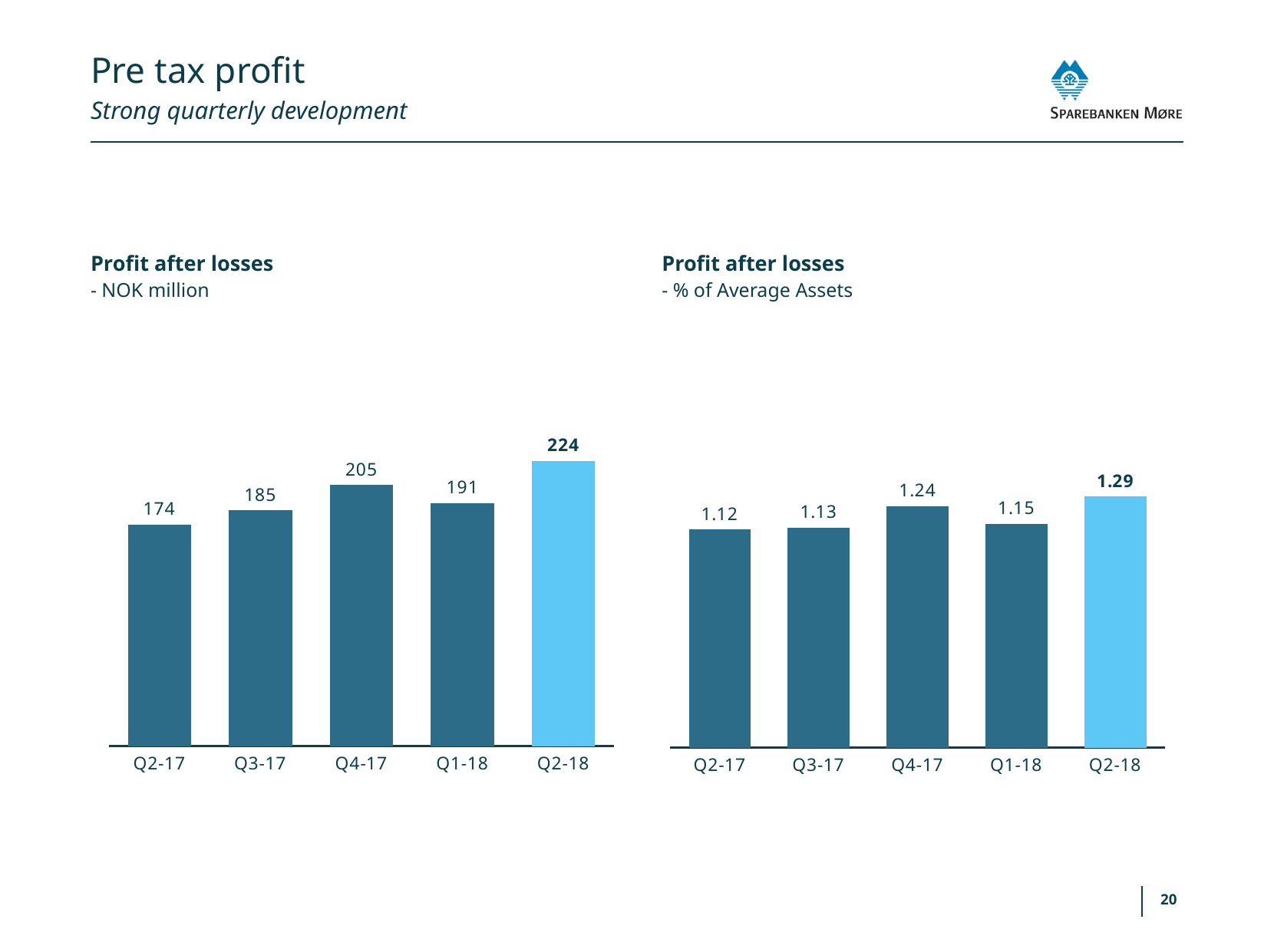
In the left chart (Profit after losses - NOK million), which is larger, Q3-17 or Q1-18? Q1-18 In the right chart (Profit after losses - % of Average Assets), what is the value for Q1-18? 1.15 How many quarters are shown in the right chart (Profit after losses - % of Average Assets)? 5 In the right chart (Profit after losses - % of Average Assets), which quarter has the highest value? Q2-18 In the left chart (Profit after losses - NOK million), which quarter has the lowest value? Q2-17 In the left chart (Profit after losses - NOK million), what is the difference between Q2-18 and Q1-18? 33 In the left chart (Profit after losses - NOK million), what is the value for Q2-18? 224 What kind of chart is the left chart (Profit after losses - NOK million)? Bar chart In the right chart (Profit after losses - % of Average Assets), what is the difference between Q4-17 and Q3-17? 0.11 In the left chart (Profit after losses - NOK million), does the value rise or fall from Q4-17 to Q1-18? Fall In the left chart (Profit after losses - NOK million), what is the value for Q4-17? 205 In the right chart (Profit after losses - % of Average Assets), which bar is shown in a lighter blue colour than the others? Q2-18